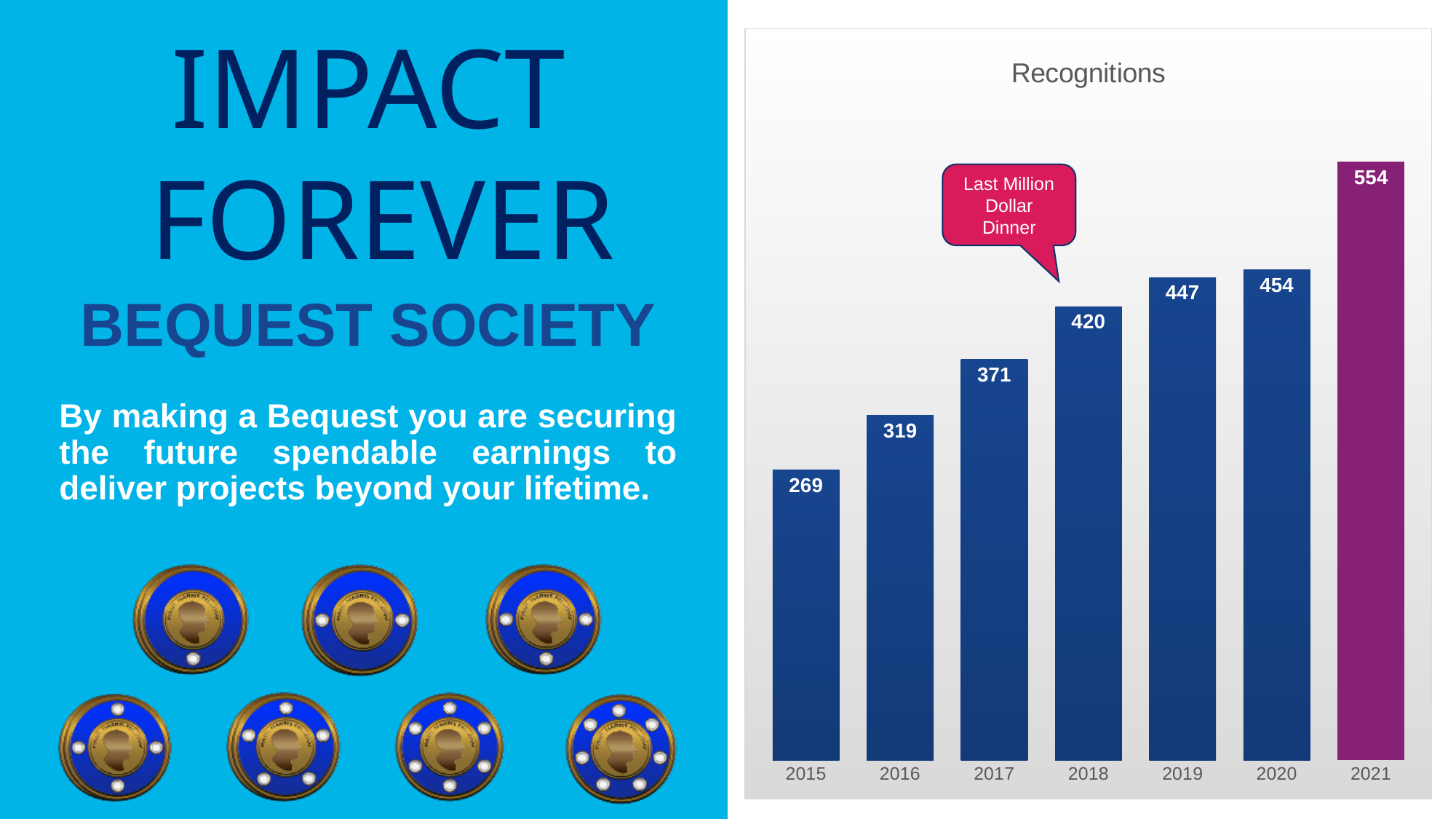
What is the value for 2018 in the Recognitions chart? 420 How many years are shown in the Recognitions chart? 7 What is the value for 2021 in the Recognitions chart? 554 Which is larger in the Recognitions chart, the value for 2017 or the value for 2019? 2019 What is the difference between the values for 2021 and 2020 in the Recognitions chart? 100 What kind of chart is the Recognitions chart? Bar chart Which year has the highest value in the Recognitions chart? 2021 What is the value for 2015 in the Recognitions chart? 269 Do the values in the Recognitions chart rise or fall from 2015 to 2021? Rise Which year's bar in the Recognitions chart is labelled with the callout 'Last Million Dollar Dinner'? 2018 Which year has the lowest value in the Recognitions chart? 2015 What is the difference between the values for 2016 and 2015 in the Recognitions chart? 50